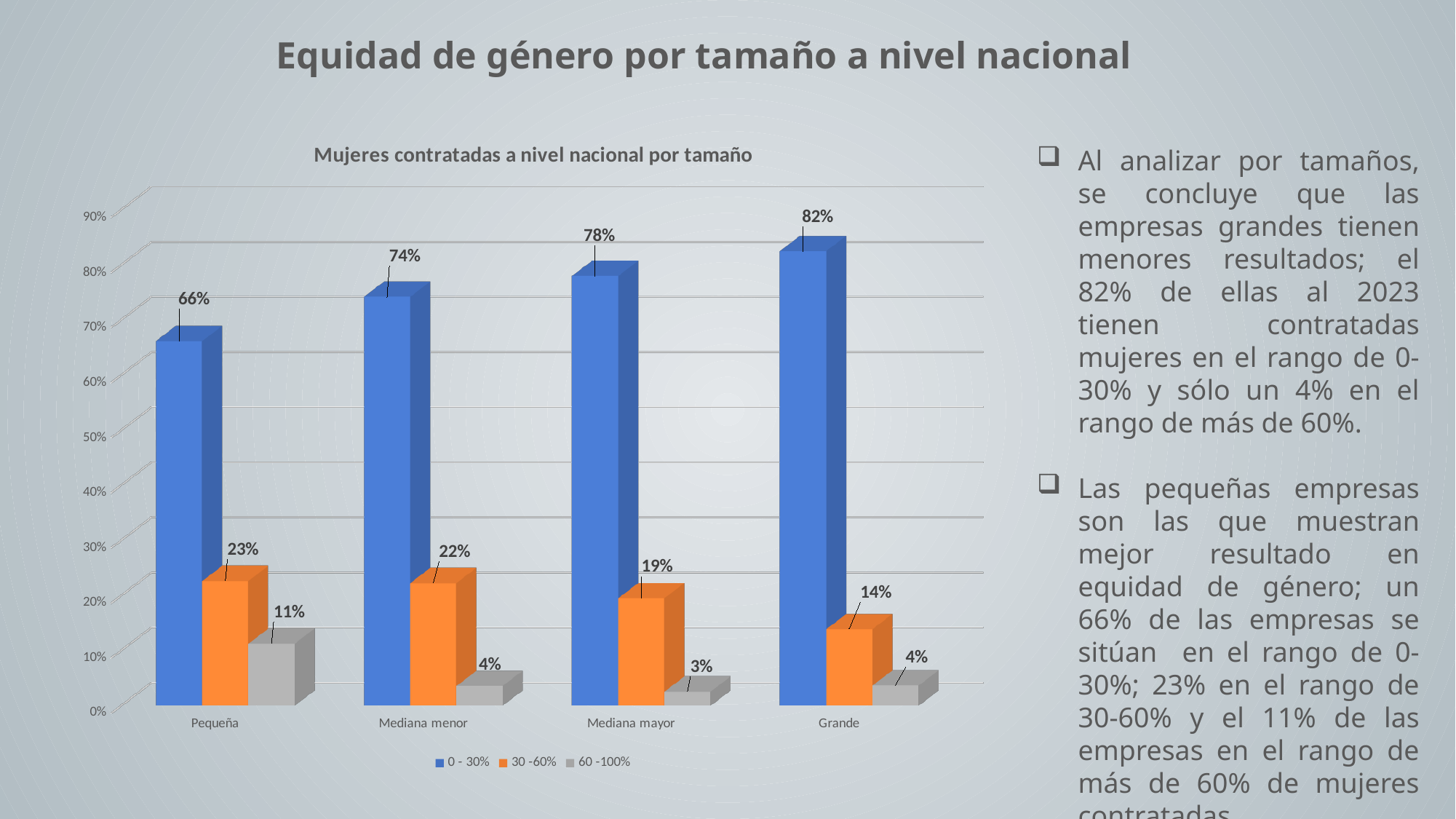
What is the title of the chart? Mujeres contratadas a nivel nacional por tamaño What is the value of the 60 -100% series for Mediana mayor? 3% What is the value of the 30 -60% series for Pequeña? 23% Do the values of the 0 - 30% series rise or fall from Pequeña to Grande? Rise Which is larger: the 30 -60% value for Mediana menor or for Grande? Mediana menor Which category has the highest value in the 0 - 30% series? Grande What is the value of the 0 - 30% series for Grande? 82% Which category has the lowest value in the 60 -100% series? Mediana mayor How many series does the legend list? 3 How many categories are shown on the x axis? 4 What kind of chart is shown? Bar chart What is the difference between the 0 - 30% values for Grande and Pequeña? 16%